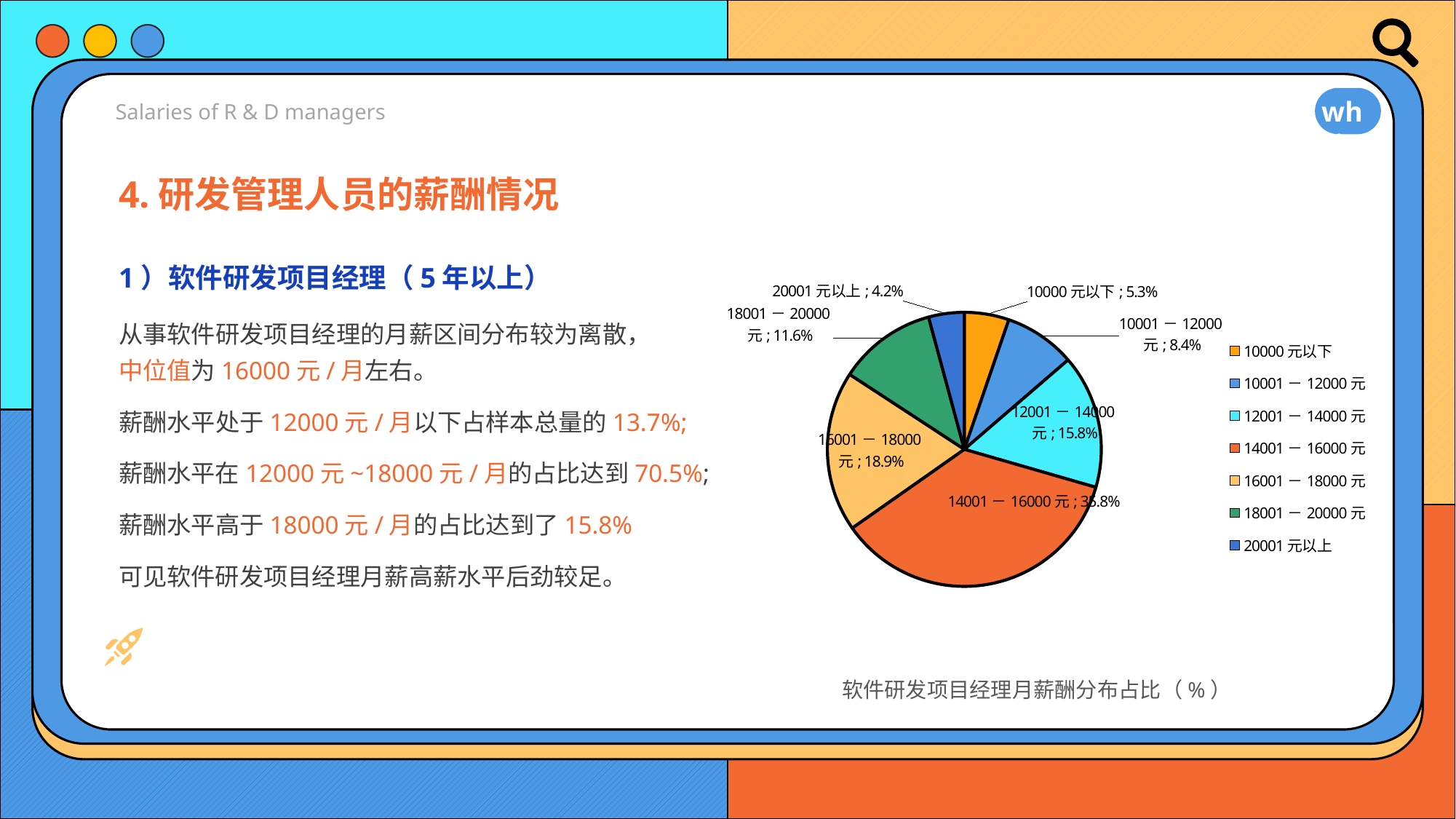
How many slices does the pie chart have? 7 What is the value shown for 10000 元以下? 5.3% What kind of chart is shown on the slide? pie chart Which salary range has the smallest share of the pie? 20001 元以上 What share of the pie is the 14001－16000 元 slice? 35.8% What is the value shown for 18001－20000 元? 11.6% What is the difference between the shares for 14001－16000 元 and 16001－18000 元? 16.9% What colour is the 10000 元以下 slice in the legend? orange What is the title of the chart? 软件研发项目经理月薪酬分布占比（%） What is the value shown for 16001－18000 元? 18.9% Which salary range has the largest share of the pie? 14001－16000 元 Which is larger, the share for 12001－14000 元 or the share for 18001－20000 元? 12001－14000 元